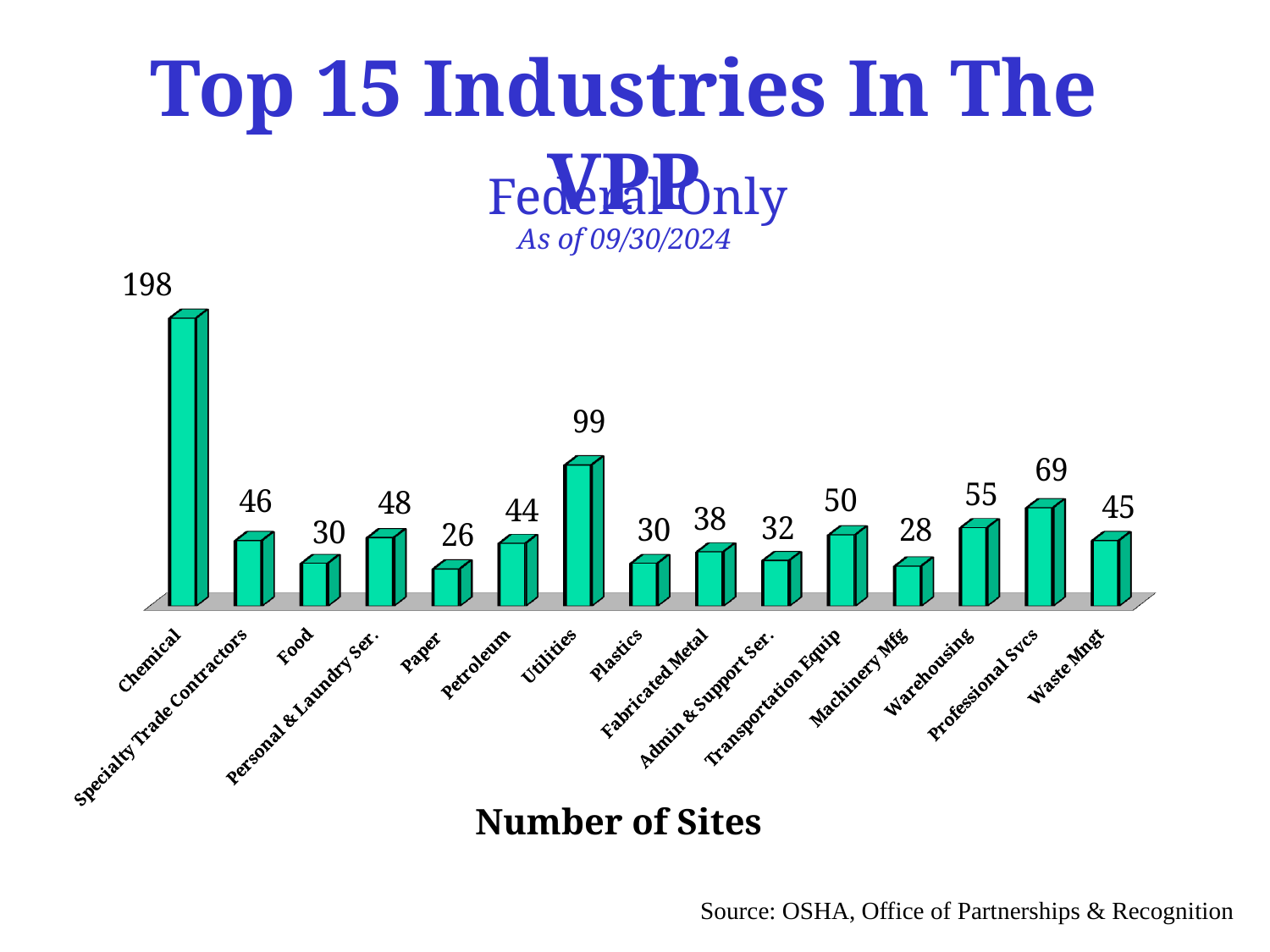
Which has more sites, Specialty Trade Contractors or Personal & Laundry Ser.? Personal & Laundry Ser. Which industry has the lowest number of sites? Paper What is the label below the chart's category axis? Number of Sites What is the difference in number of sites between Warehousing and Transportation Equip? 5 How many industries are shown in the chart? 15 How many sites does Machinery Mfg have? 28 What is the number of sites for Utilities? 99 What is the number of sites for Professional Svcs? 69 Which industry has the highest number of sites? Chemical How many sites does the Chemical industry have? 198 What type of chart is shown on the slide? Bar chart What is the difference in number of sites between Chemical and Utilities? 99